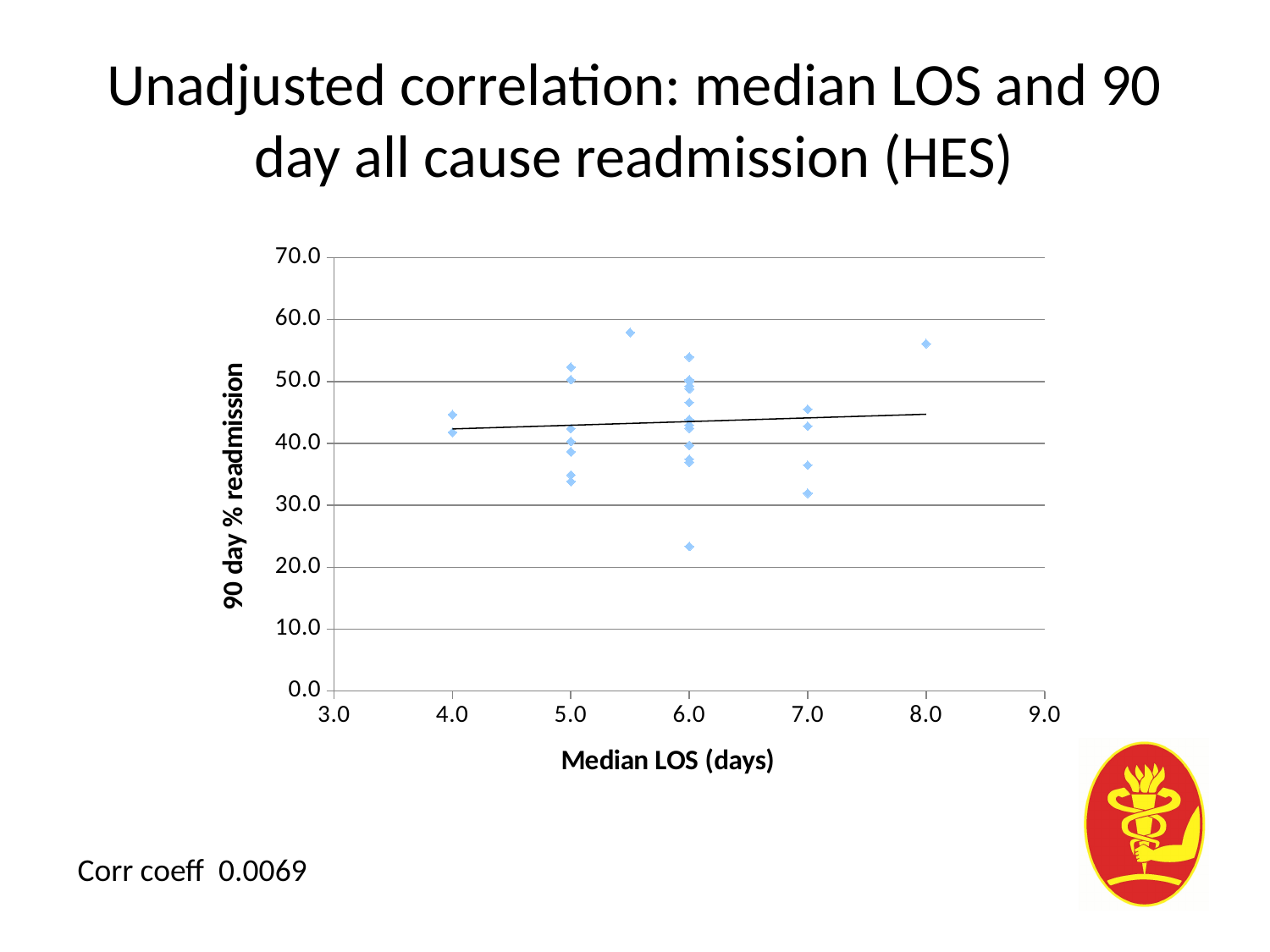
What is the maximum value shown on the y axis? 70.0 Does the fitted trend line rise or fall as median LOS increases? rises Is the 90 day % readmission value for the point at a median LOS of 5.5 days greater or less than 50.0? greater Is the highest 90 day % readmission value plotted at a median LOS of 4.0 days greater or less than 40.0? greater Is the 90 day % readmission value for the point at a median LOS of 8.0 days greater or less than 50.0? greater At which median LOS value is the lowest 90 day % readmission point plotted? 6.0 At which median LOS value are the most points plotted? 6.0 What is the title of the x axis? Median LOS (days) What is the title of the y axis? 90 day % readmission What kind of chart is shown on the slide? scatter chart